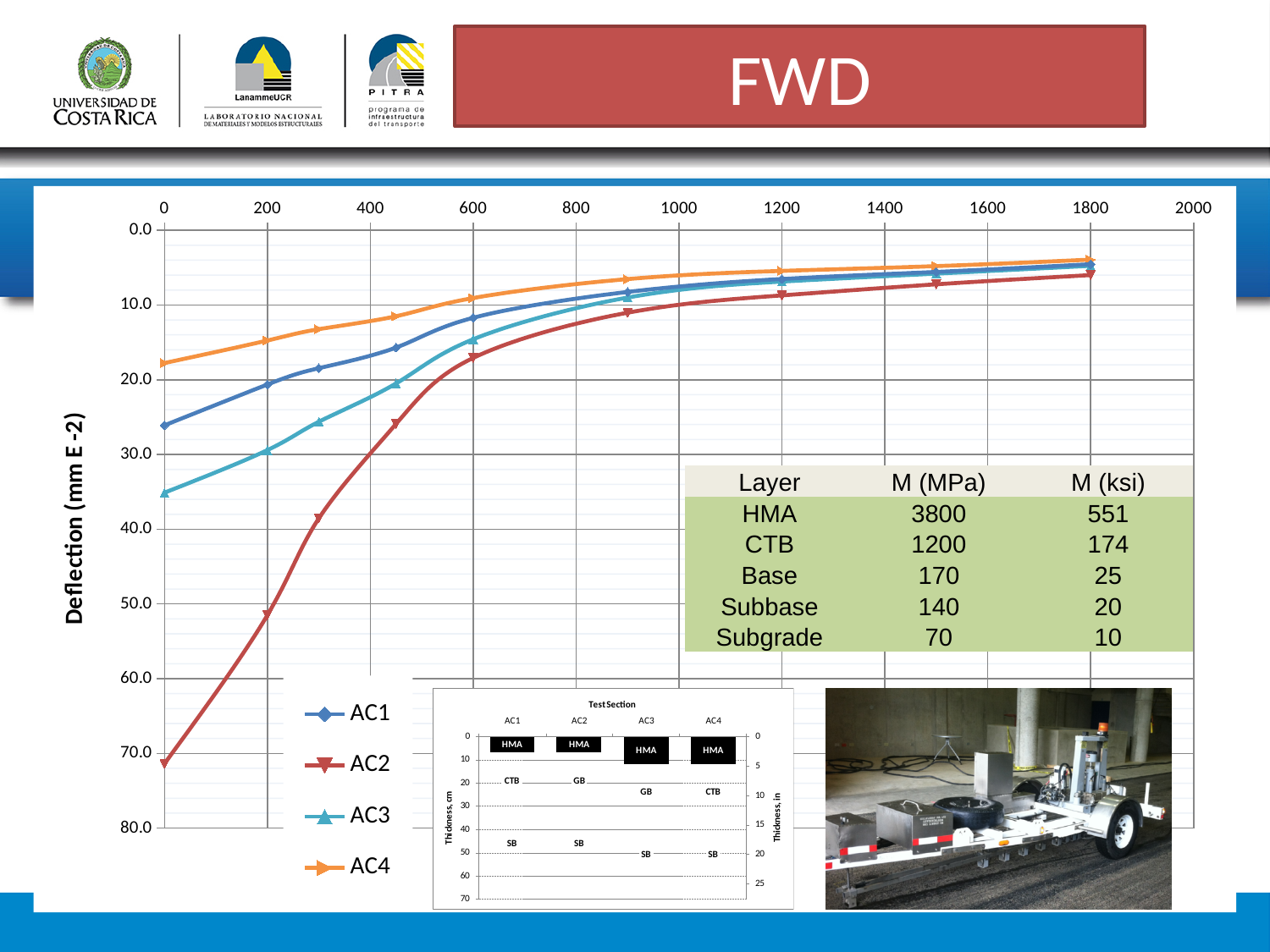
How many series does the legend of the main chart list? 4 In the main chart, is the deflection for AC4 at x = 0 greater or less than 20? less In the main chart, at x = 200, which series has the larger deflection, AC1 or AC2? AC2 In the main chart, is the deflection for AC2 at x = 0 greater or less than 70? greater What kind of chart is the main chart on the slide? line chart In the main chart, is the deflection for AC3 at x = 0 greater or less than 30? greater In the main chart, which series has the lowest deflection at x = 0? AC4 In the main chart, which series has the highest deflection at x = 0? AC2 In the main chart, do the deflection values rise or fall as the x-axis value increases? fall What is the y-axis label of the main chart? Deflection (mm E -2)